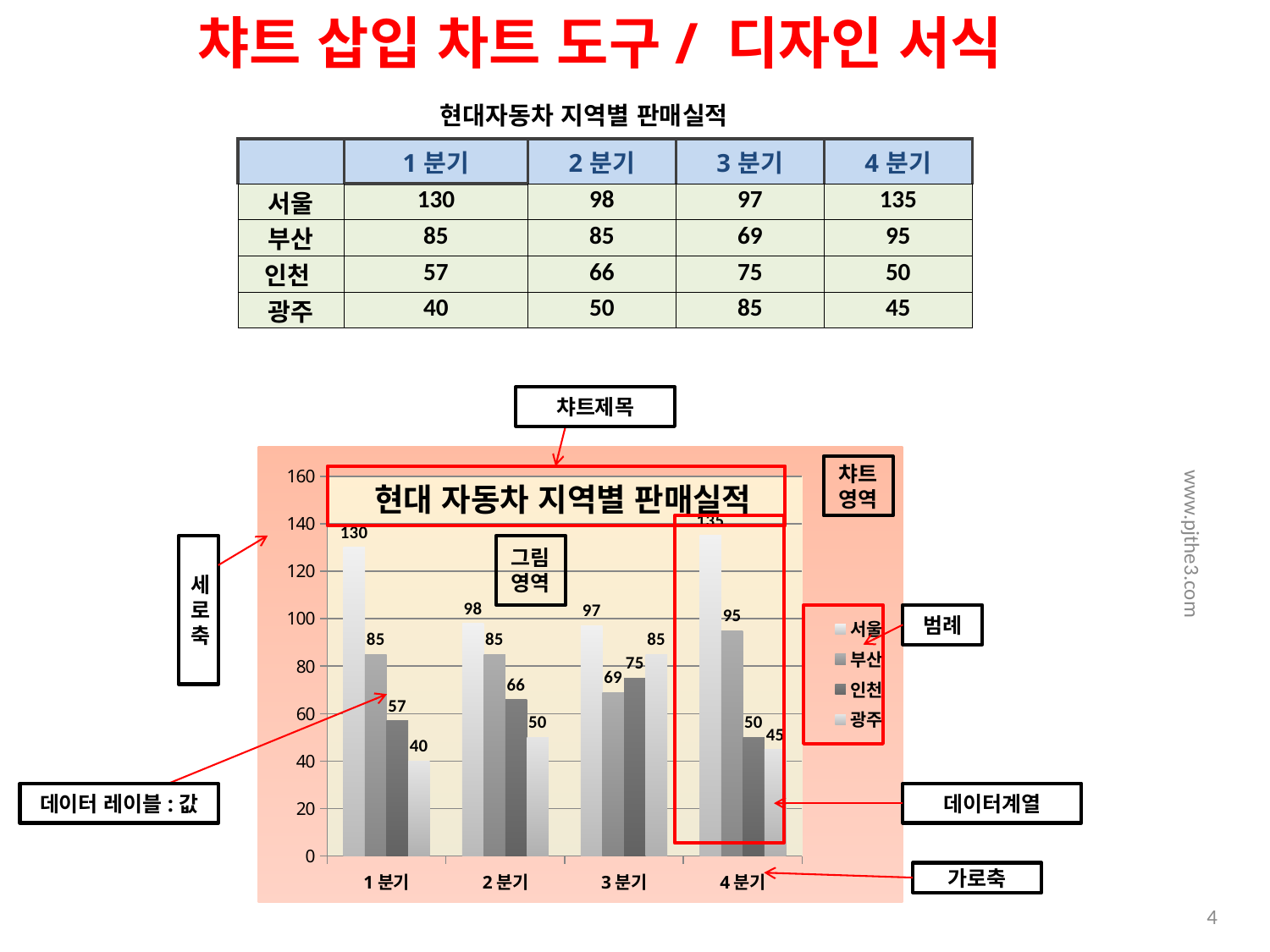
What kind of chart is shown on the slide? bar chart Does the value for 서울 rise or fall from 1 분기 to 2 분기? fall In which quarter is the value for 광주 the lowest? 1 분기 What is the title of the chart? 현대 자동차 지역별 판매실적 What is the difference between the 서울 value and the 부산 value in 4 분기? 40 Which is larger in 2 분기, the value for 인천 or the value for 광주? 인천 What is the value for 광주 in 3 분기? 85 How many series does the chart legend list? 4 How many categories are shown on the x axis of the chart? 4 In which quarter is the value for 서울 the highest? 4 분기 What is the value for 인천 in 4 분기? 50 What is the value for 서울 in 1 분기? 130